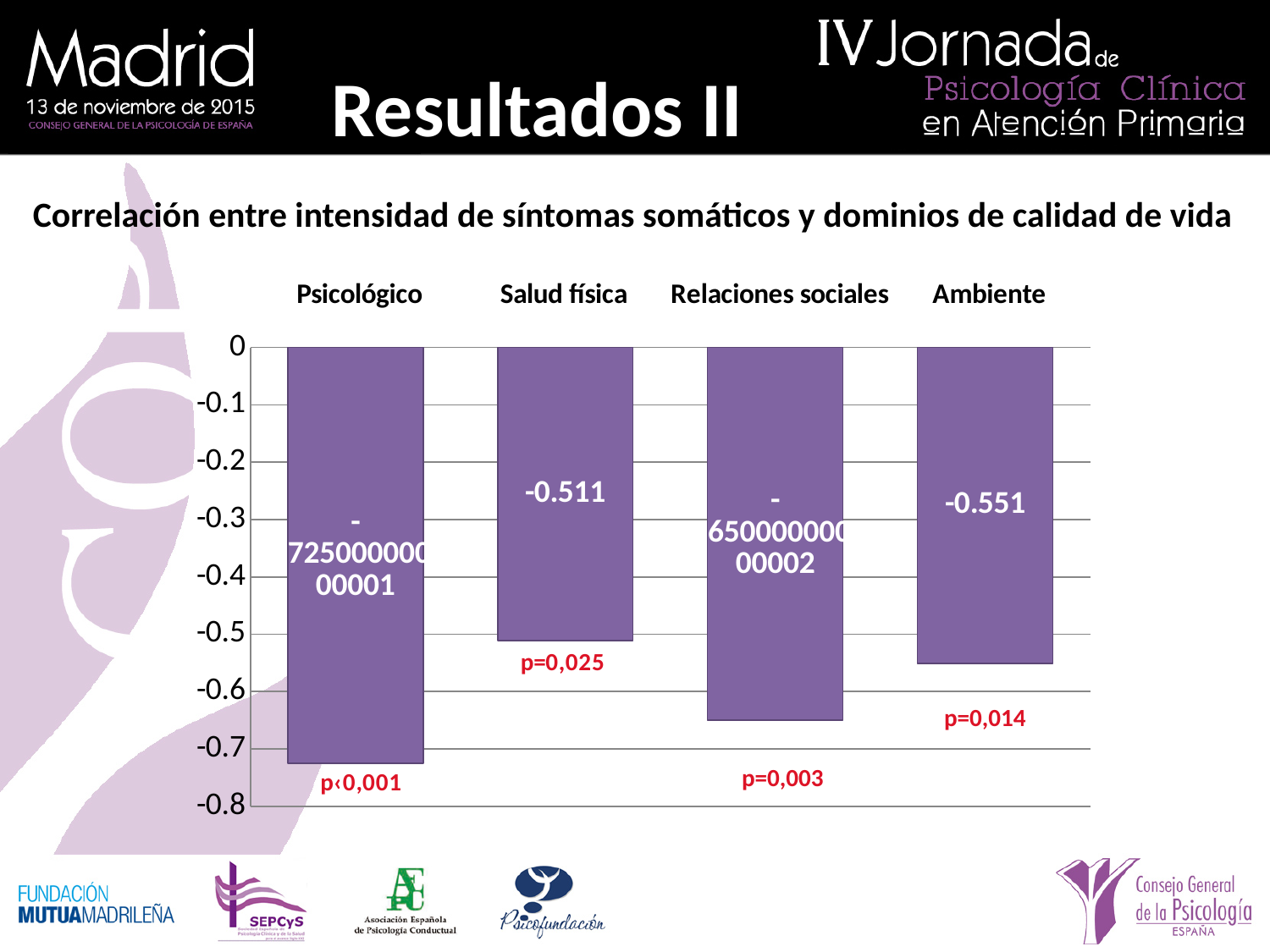
What is the correlation value shown for Ambiente? -0.551 What is the correlation value shown for Salud física? -0.511 What type of chart is shown on the slide? bar chart What p-value is printed below the Relaciones sociales bar? p=0,003 What is the title of the chart on the slide? Correlación entre intensidad de síntomas somáticos y dominios de calidad de vida Which category has the correlation value closest to zero? Salud física Is the value for Psicológico greater or less than -0.7? less Is the value for Relaciones sociales greater or less than -0.6? less Which has the larger (less negative) value, Salud física or Ambiente? Salud física Which category's bar extends furthest below zero (the strongest negative correlation)? Psicológico What is the difference between the values for Salud física (-0.511) and Ambiente (-0.551)? 0.04 How many categories (domains) are plotted in the chart? 4